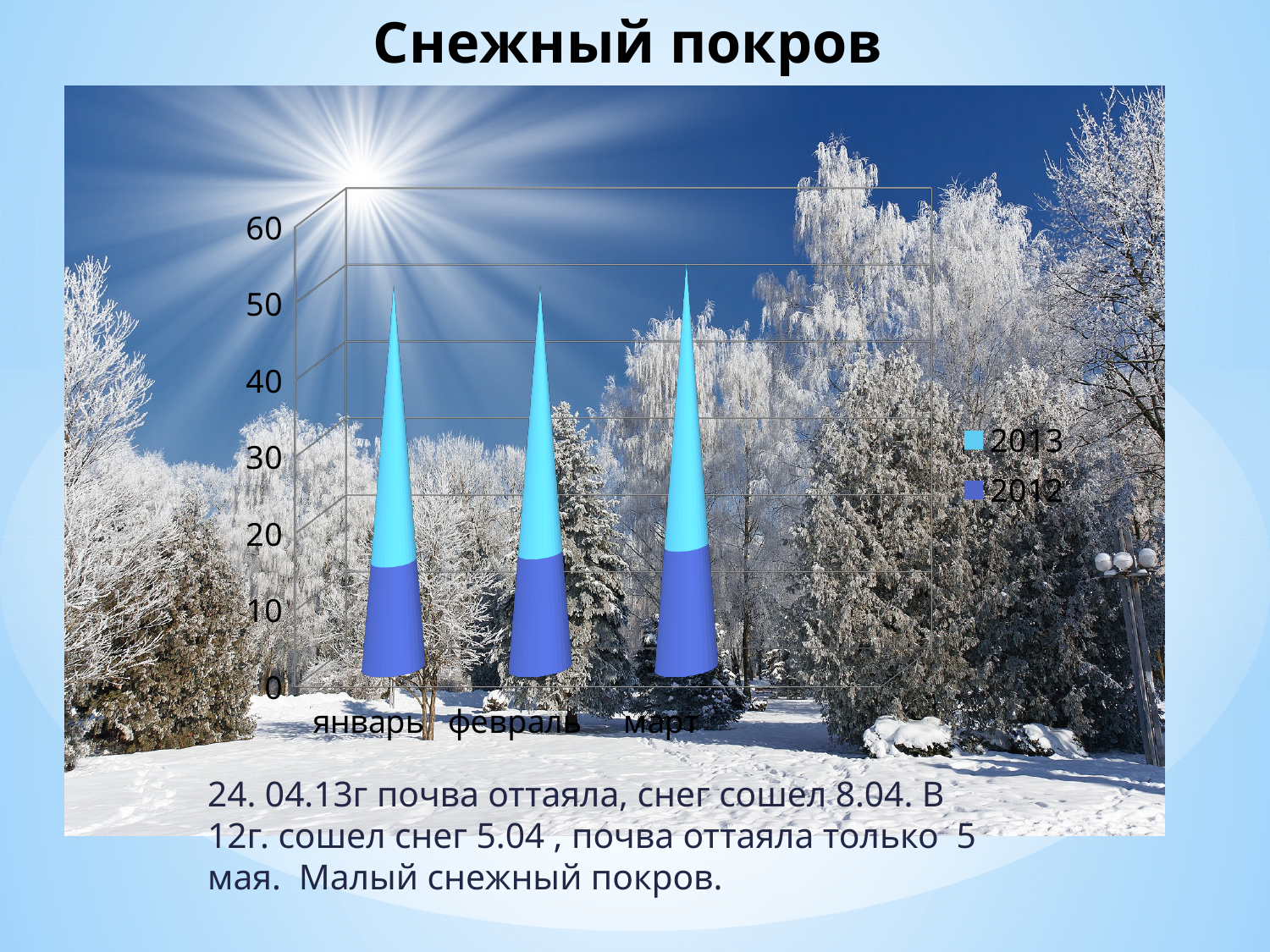
Is the total stacked value for март greater or less than 60? less Is the 2012 value for январь greater or less than 20? less What is the highest value shown on the vertical axis? 60 Which category has the tallest stacked bar? март How many series does the chart legend list? 2 Is the total stacked value for январь greater or less than 40? greater How many categories are shown on the x axis of the chart? 3 What are the series names listed in the chart legend? 2013, 2012 What kind of chart is shown on the slide? bar chart What is the title of the slide containing the chart? Снежный покров